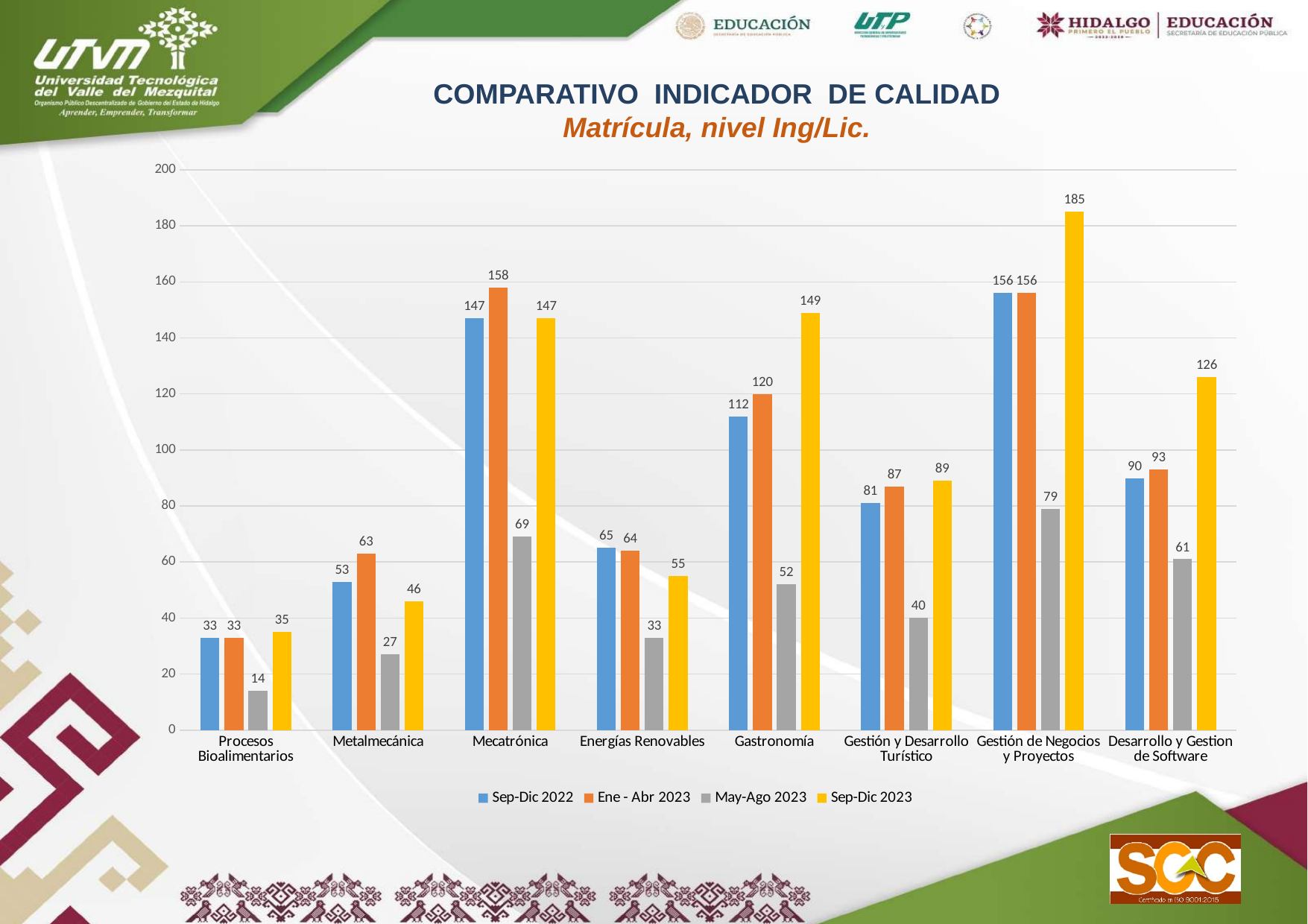
What is the Sep-Dic 2023 value for Gestión de Negocios y Proyectos? 185 Which category has the lowest May-Ago 2023 value? Procesos Bioalimentarios Is the Sep-Dic 2022 value for Gestión y Desarrollo Turístico greater or less than 100? less What is the May-Ago 2023 value for Procesos Bioalimentarios? 14 Which series is shown in gray in the legend? May-Ago 2023 How many categories are shown on the x axis? 8 How many series does the legend list? 4 What is the difference between the Sep-Dic 2023 and Sep-Dic 2022 values for Desarrollo y Gestion de Software? 36 What kind of chart is shown on the slide? bar chart What is the Ene - Abr 2023 value for Mecatrónica? 158 Which is larger for Gastronomía: the Ene - Abr 2023 value or the Sep-Dic 2023 value? Sep-Dic 2023 Which category has the highest Sep-Dic 2023 value? Gestión de Negocios y Proyectos